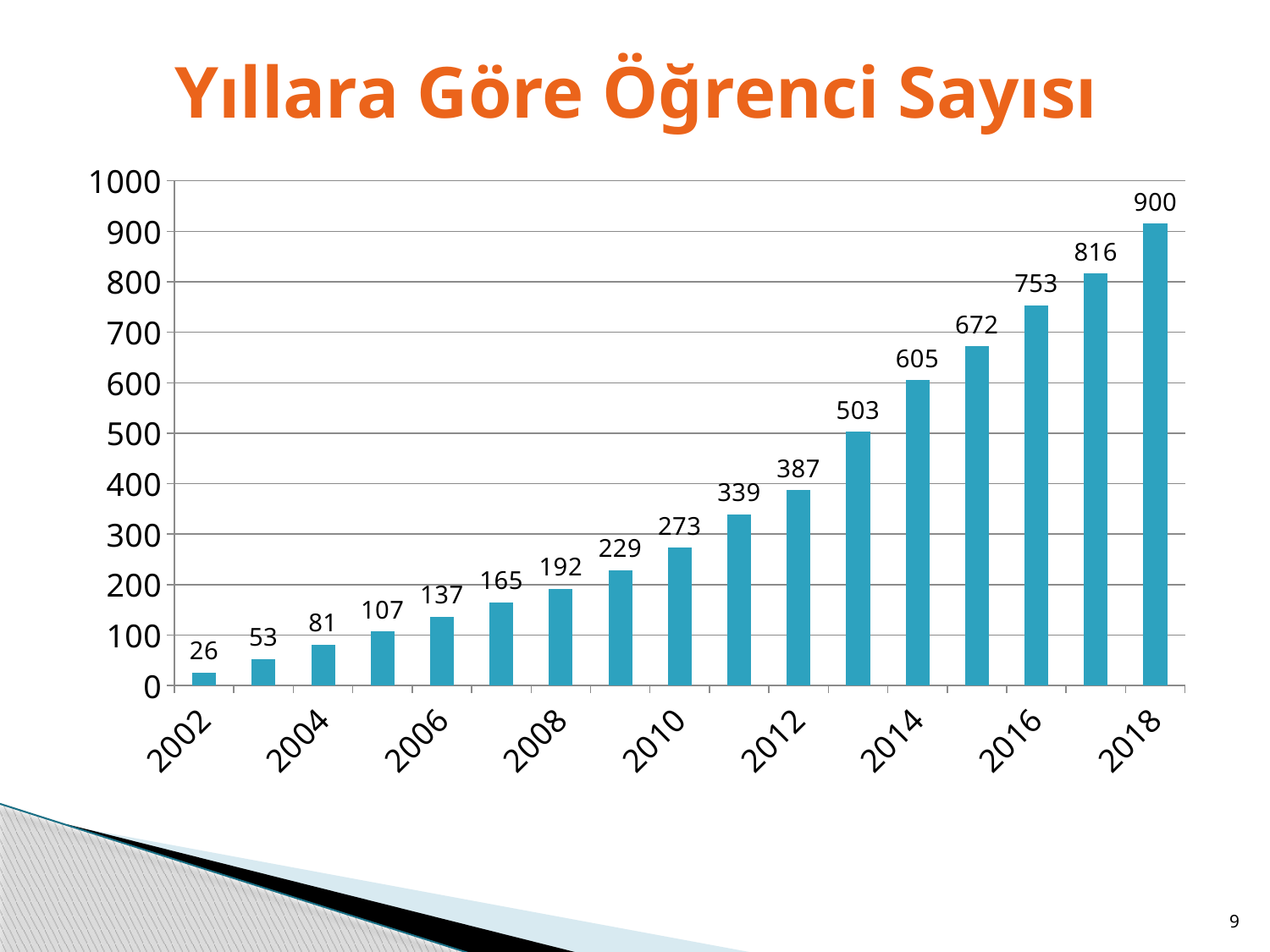
Do the values rise or fall from 2002 to 2018? rise What is the difference between the values for 2008 and 2004? 111 What is the difference between the values for 2018 and 2014? 295 What is the value for 2016? 753 Is the value for 2014 greater or less than 500? greater Which is larger, the value for 2012 or the value for 2006? 2012 What is the value for 2002? 26 What kind of chart is shown on the slide? bar chart Which year has the highest value? 2018 How many bars are shown in the chart? 17 Which year has the lowest value? 2002 What is the value for 2010? 273